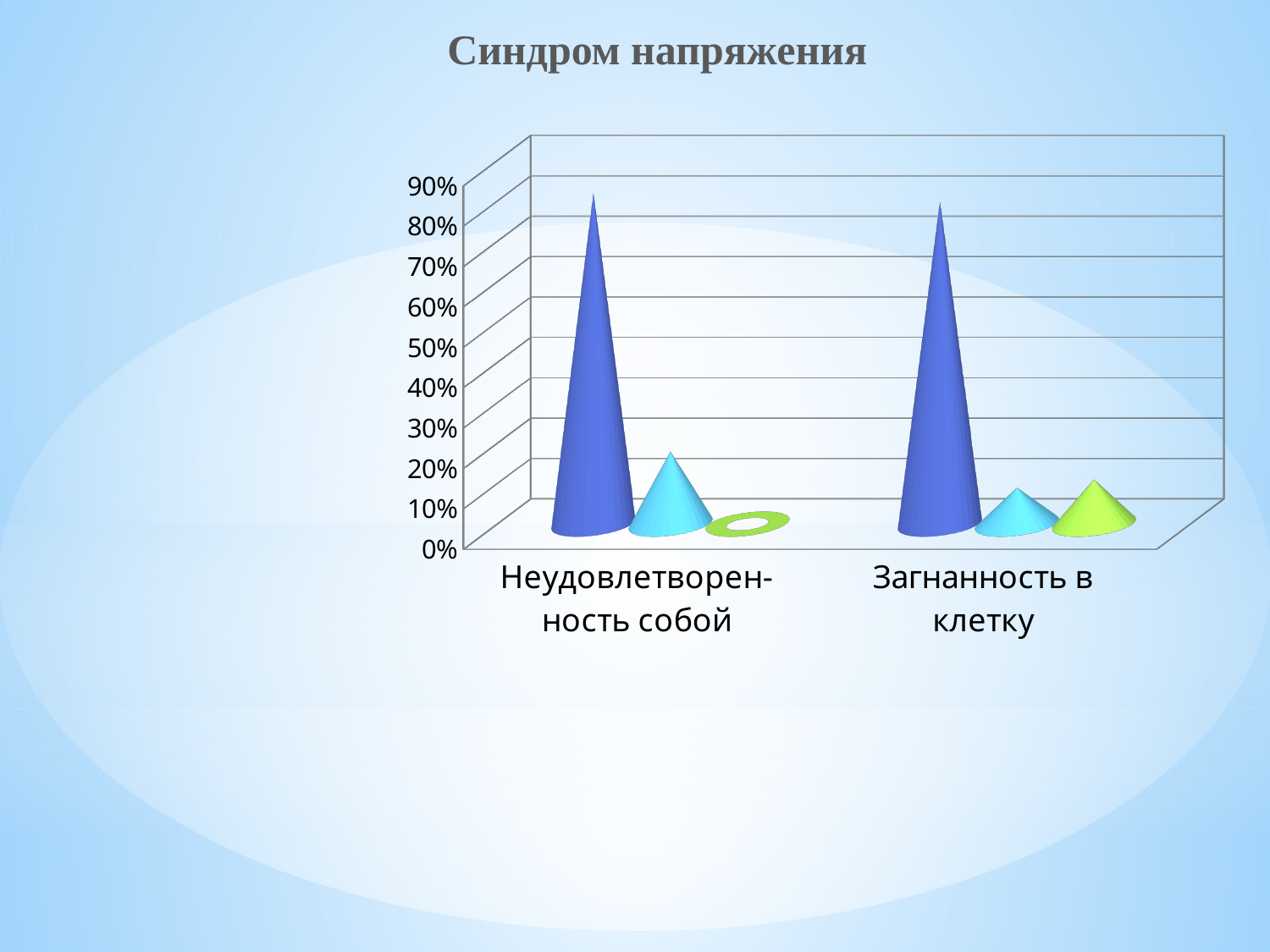
What is the title of the chart? Синдром напряжения How many categories are shown on the x axis of the chart? 2 Is the light blue bar larger for Неудовлетворенность собой or for Загнанность в клетку? Неудовлетворенность собой Is the value of the green bar for Неудовлетворенность собой greater or less than 10%? less Is the value of the dark blue bar for Неудовлетворенность собой greater or less than 70%? greater What kind of chart is shown on the slide? bar chart Is the value of the green bar for Загнанность в клетку greater or less than 20%? less Which bar is the lowest for the category Загнанность в клетку? the light blue bar Which bar is the highest for the category Неудовлетворенность собой? the dark blue bar